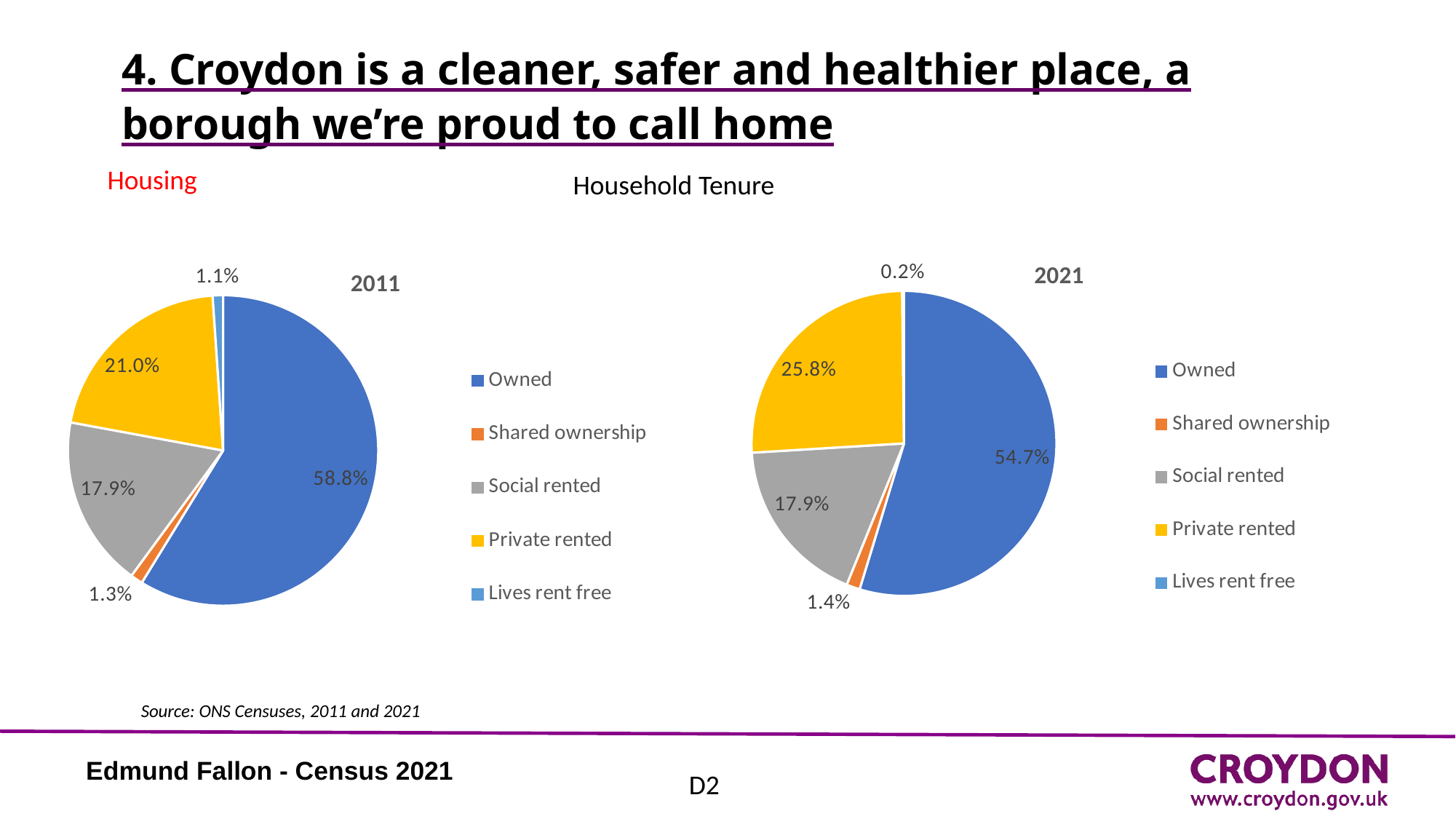
In the 2021 pie chart, what share of households is Private rented? 25.8% What type of chart is used to show Household Tenure for 2011? Pie chart In the 2021 pie chart, which category has the largest share? Owned In the 2011 pie chart, what share of households is Owned? 58.8% How many categories does the legend of the 2021 pie chart list? 5 In the 2021 pie chart, what is the value for Lives rent free? 0.2% In the 2011 pie chart, what is the value for Shared ownership? 1.3% Is the Owned share larger in the 2011 pie chart or the 2021 pie chart? 2011 What is the difference between the Private rented share in 2021 and in 2011? 4.8% What colour represents Social rented in both pie charts? Grey In the 2011 pie chart, which category has the smallest share? Lives rent free In the 2011 pie chart, what is the difference between the Owned share and the Social rented share? 40.9%